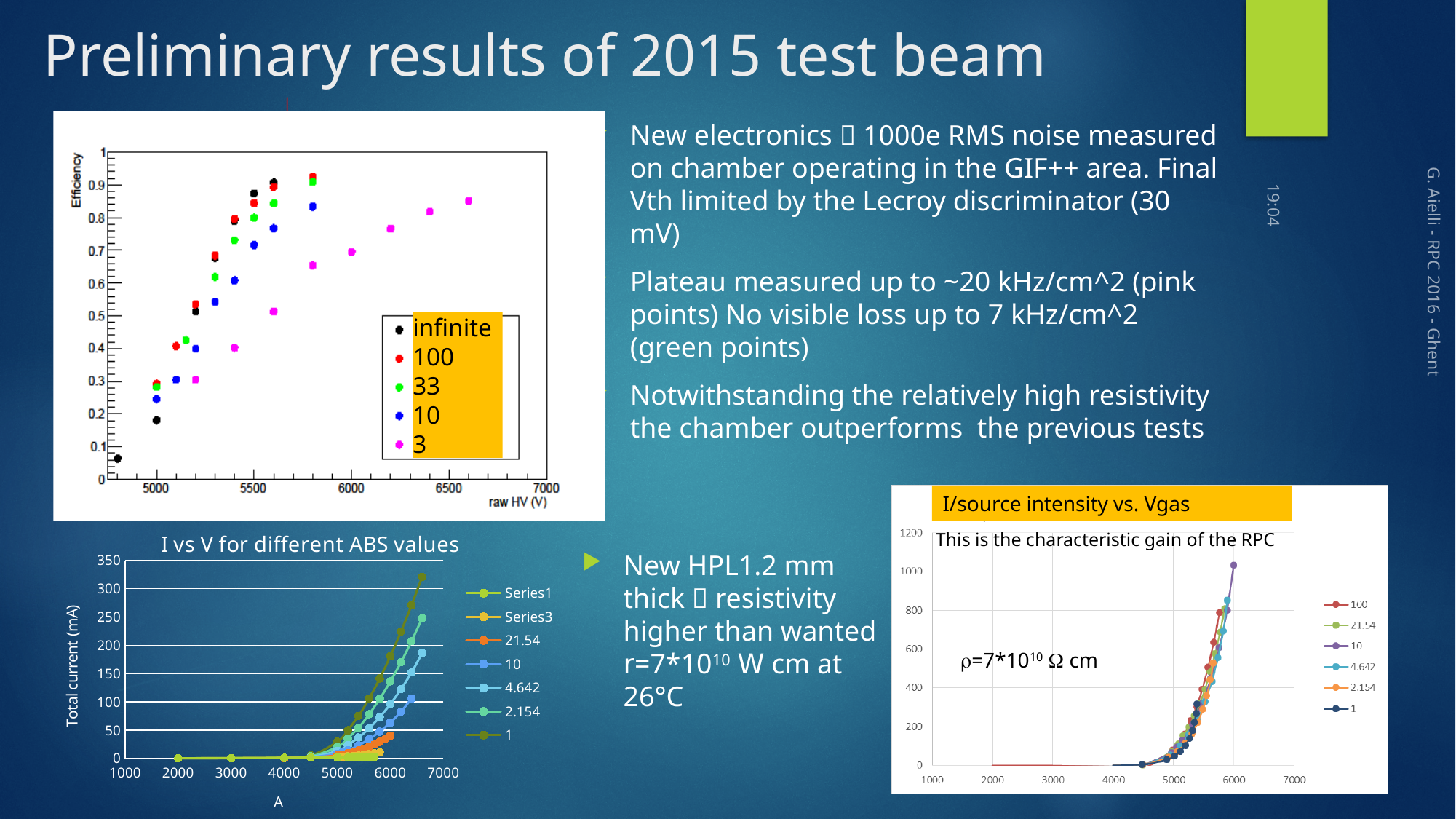
In the chart titled 'I/source intensity vs. Vgas', is the highest plotted value of series '10' greater or less than 1000? greater What is the title of the bottom-left chart? I vs V for different ABS values In the top-left chart (Efficiency vs raw HV), is the efficiency of the pink (3) series at 5400 V greater or less than 0.5? less In the top-left chart (Efficiency vs raw HV), what is the label of the y axis? Efficiency In the top-left chart (Efficiency vs raw HV), does efficiency generally rise or fall as raw HV increases? rise In the chart titled 'I vs V for different ABS values', is the highest value of series '1' greater or less than 300? greater In the chart titled 'I/source intensity vs. Vgas', how many series does the legend list? 6 In the chart titled 'I vs V for different ABS values', how many series does the legend list? 7 In the top-left chart (Efficiency vs raw HV), how many entries does the legend list? 5 What kind of chart is 'I vs V for different ABS values'? line chart In the chart titled 'I vs V for different ABS values', which series reaches the highest total current? 1